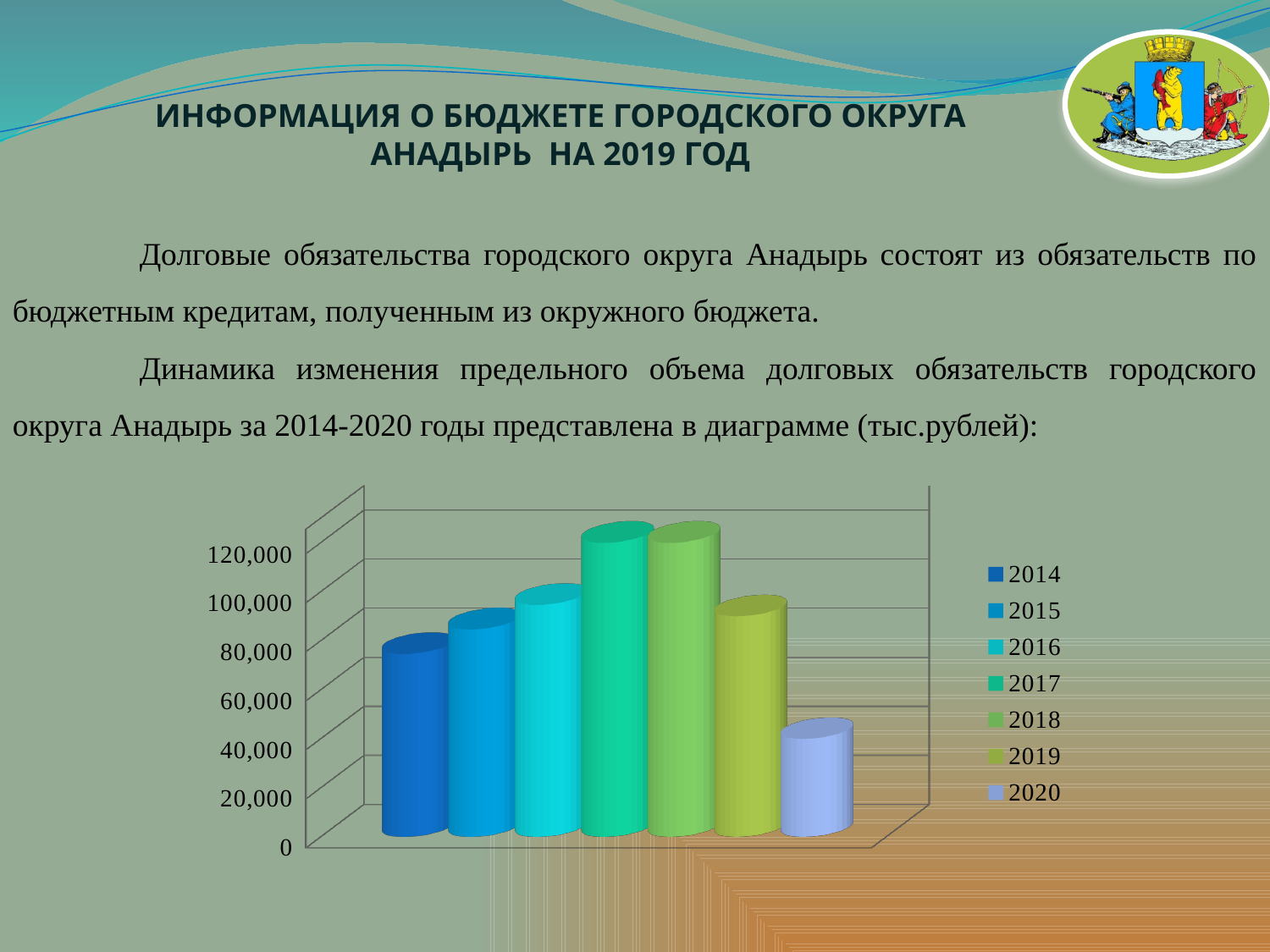
Do the values rise or fall from 2014 to 2017? rise Which is larger, the value for 2016 or the value for 2014? 2016 How many bars are plotted in the chart? 7 Is the value for 2018 greater or less than 100,000? greater Is the value for 2019 greater or less than 120,000? less Which is larger, the value for 2014 or the value for 2020? 2014 What kind of chart is shown on the slide? bar chart Is the value for 2014 greater or less than 100,000? less Which year has the lowest value in the chart? 2020 How many series does the chart legend list? 7